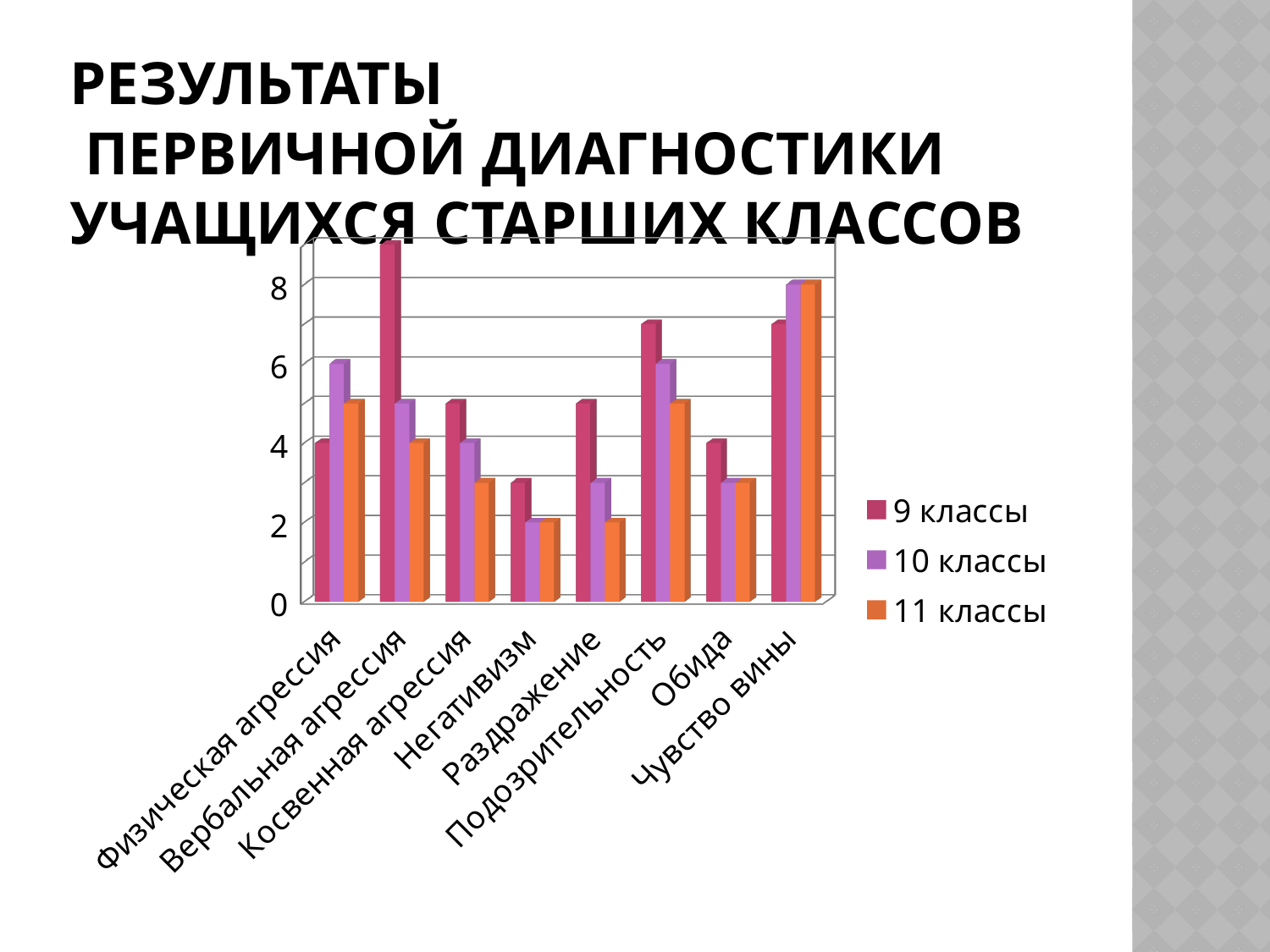
What kind of chart is shown on the slide? bar chart How many series does the chart legend list? 3 What are the three series listed in the chart legend? 9 классы, 10 классы, 11 классы Which category has the highest value for the 9 классы series? Вербальная агрессия Is the value for Негативизм in the 10 классы series greater or less than 4? less How many categories are shown along the x axis of the chart? 8 Is the value for Подозрительность in the 9 классы series greater or less than 6? greater Is the value for Обида in the 11 классы series greater or less than 4? less For Раздражение, which series has the larger value: 9 классы or 11 классы? 9 классы Which category has the lowest value for the 9 классы series? Негативизм For Физическая агрессия, which series has the larger value: 9 классы or 10 классы? 10 классы